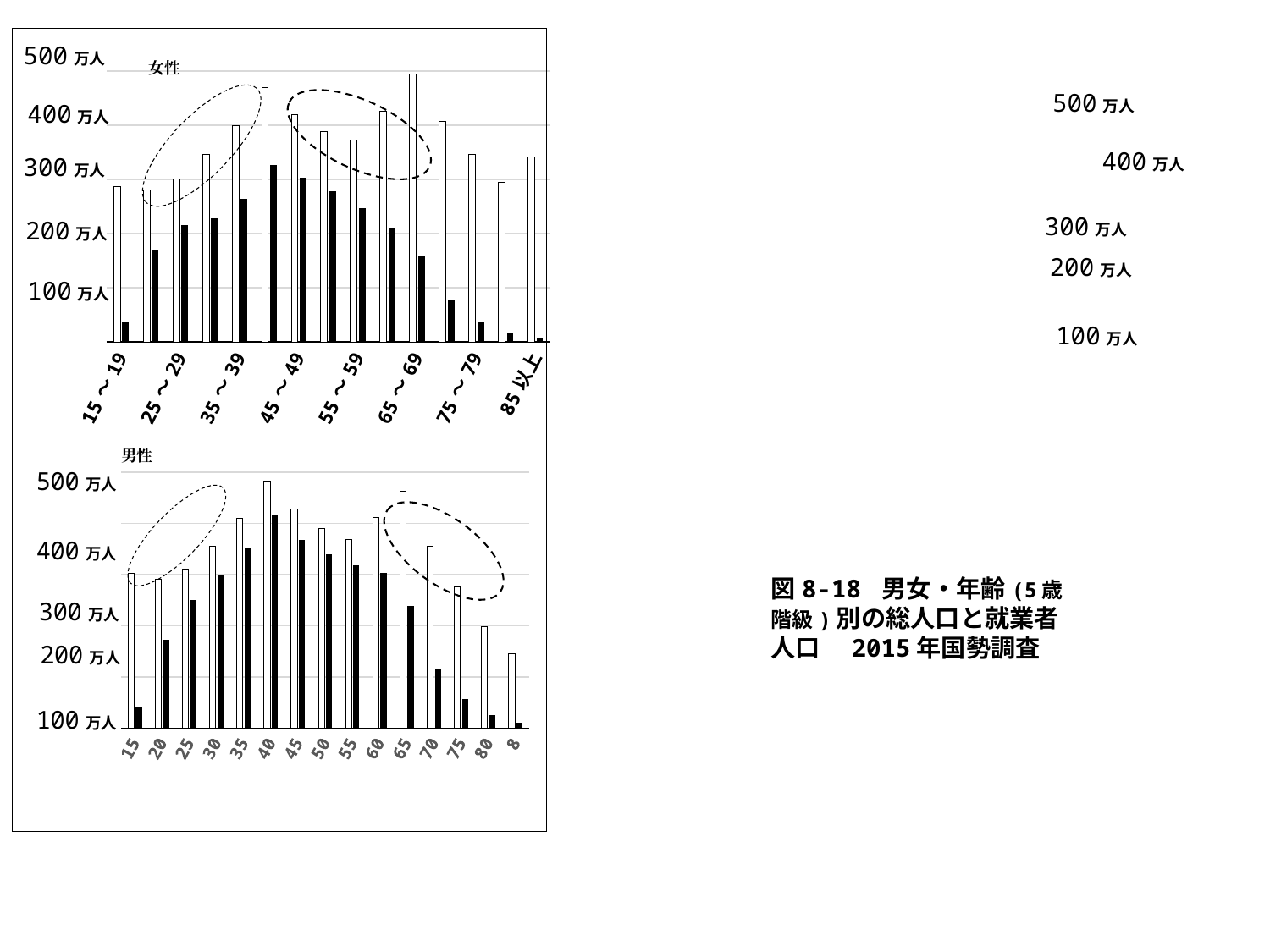
In the top chart (女性), is the black bar for 35～39 greater or less than 300万人? less In the top chart (女性), which is taller: the black bar for 25～29 or the black bar for 35～39? 35～39 What kind of chart is the top chart labelled 女性? bar chart In the top chart (女性), is the white bar for 65～69 greater or less than 400万人? greater In the bottom chart (男性), which age category has the tallest black bar? 40 In the bottom chart (男性), is the white bar for 40 greater or less than 400万人? greater In the top chart (女性), do the black bars rise or fall from 45～49 to 85以上? fall How many age categories are labelled on the x axis of the bottom chart (男性)? 15 What label appears above the bottom chart? 男性